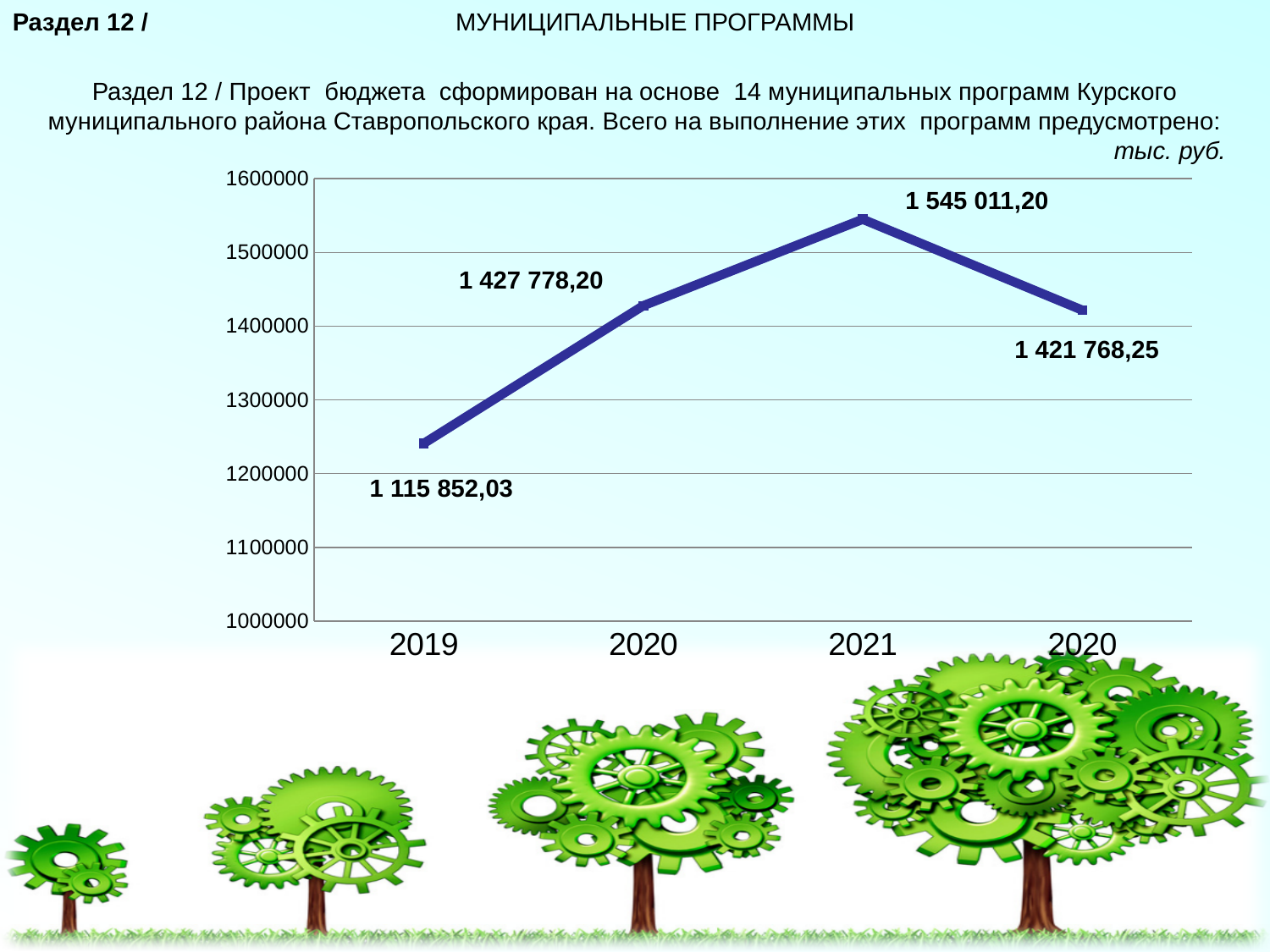
Which is larger, the value for 2019 or the value for 2021? 2021 What is the difference between the value for 2021 and the value for the last point on the x axis? 123 242,95 What type of chart is shown on the slide? line chart What unit is indicated above the chart? тыс. руб. What is the value for 2019? 1 115 852,03 Which year has the highest value? 2021 What is the value for the second point on the x axis (the first one labelled 2020)? 1 427 778,20 What is the difference between the value for 2021 and the value for 2019? 429 159,17 What is the value for 2021? 1 545 011,20 How many data points are plotted on the line? 4 What is the value for the last (fourth) point on the x axis? 1 421 768,25 Which year has the lowest value? 2019